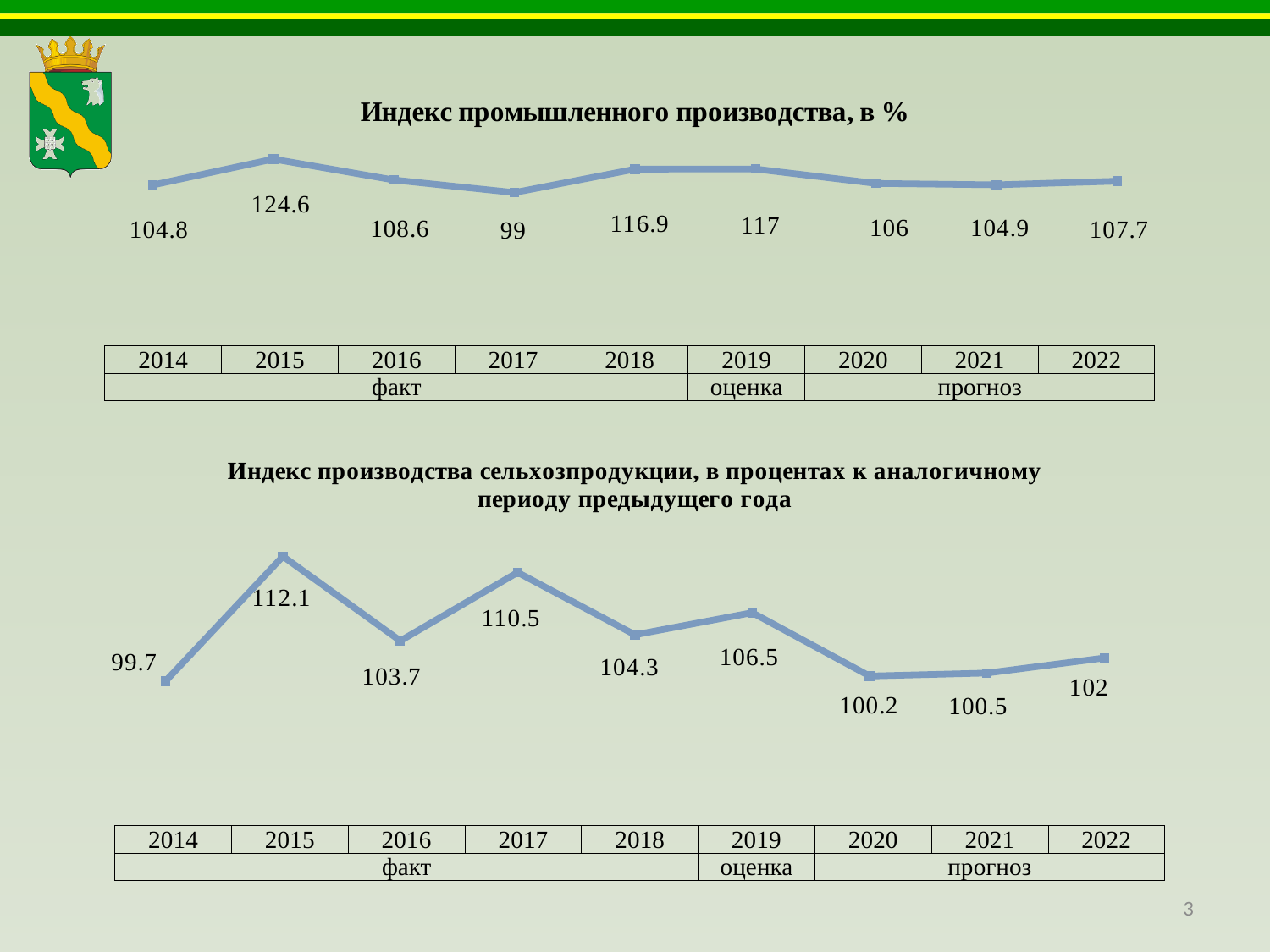
On the bottom chart (Индекс производства сельхозпродукции), which year has the highest value? 2015 On the bottom chart (Индекс производства сельхозпродукции), which year has the lowest value? 2014 On the top chart (Индекс промышленного производства), which year has the lowest value? 2017 On the top chart (Индекс промышленного производства), what is the value for 2015? 124.6 On the bottom chart (Индекс производства сельхозпродукции), what is the difference between the values for 2015 and 2016? 8.4 On the top chart (Индекс промышленного производства), how many data points are plotted? 9 On the bottom chart (Индекс производства сельхозпродукции), which is larger, the value for 2017 or the value for 2019? 2017 On the bottom chart (Индекс производства сельхозпродукции), what is the value for 2020? 100.2 On the top chart (Индекс промышленного производства), what is the difference between the values for 2018 and 2017? 17.9 On the top chart (Индекс промышленного производства), what is the value for 2017? 99 On the top chart (Индекс промышленного производства), which year has the highest value? 2015 What type of chart is the bottom chart (Индекс производства сельхозпродукции)? Line chart